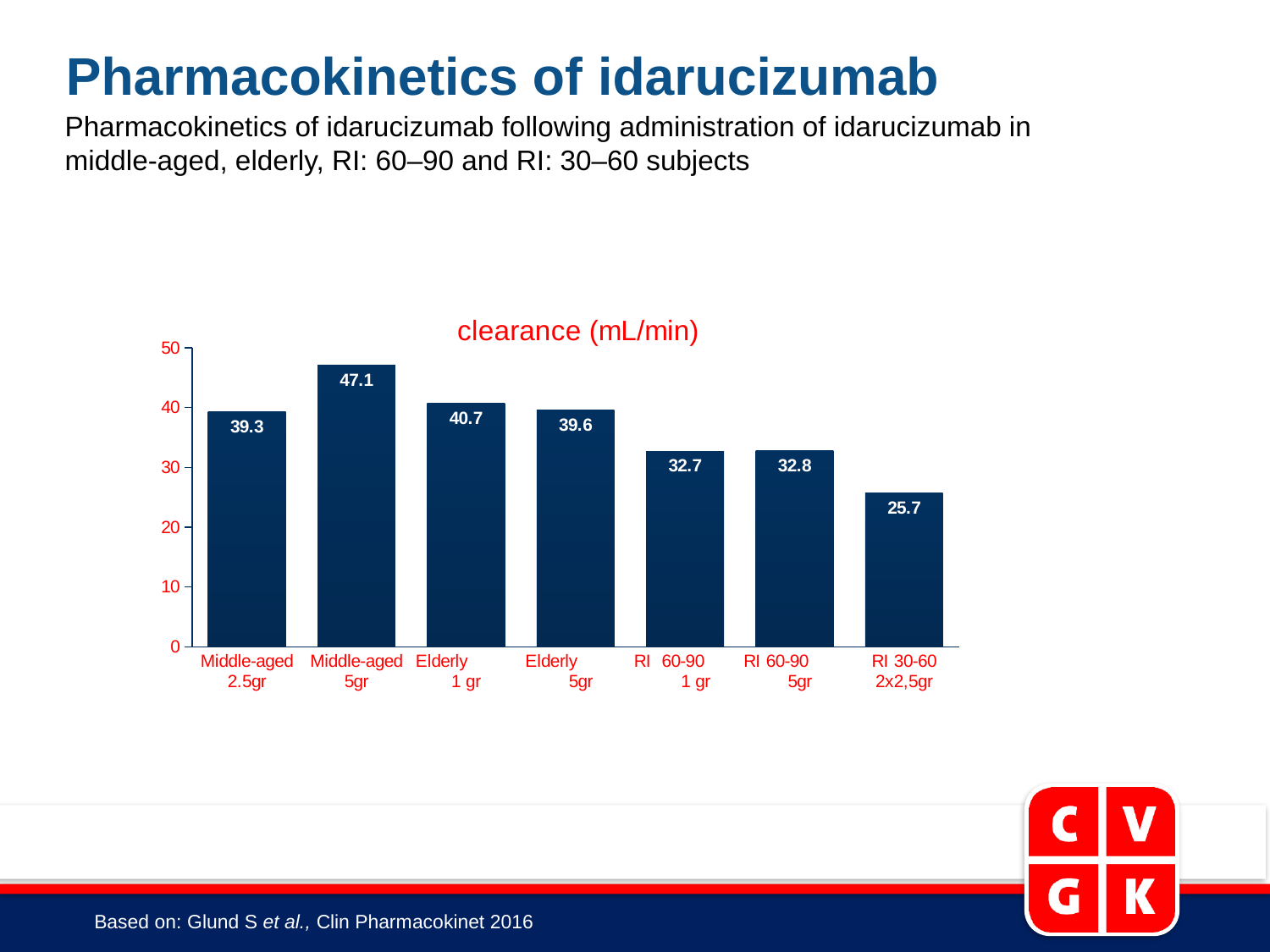
What is the clearance value for RI 30-60 2x2,5gr? 25.7 Is the clearance value for RI 60-90 5gr greater or less than 40? less What is the clearance value for Middle-aged 5gr? 47.1 What kind of chart is shown on the slide? bar chart Which category has the lowest clearance? RI 30-60 2x2,5gr Which category has the highest clearance? Middle-aged 5gr What is the difference in clearance between Elderly 5gr and RI 30-60 2x2,5gr? 13.9 How many categories are shown in the chart? 7 What is the title of the chart? clearance (mL/min) What is the clearance value for Elderly 1 gr? 40.7 Which has a higher clearance, Elderly 1 gr or RI 60-90 1 gr? Elderly 1 gr What is the difference in clearance between Middle-aged 5gr and Middle-aged 2.5gr? 7.8